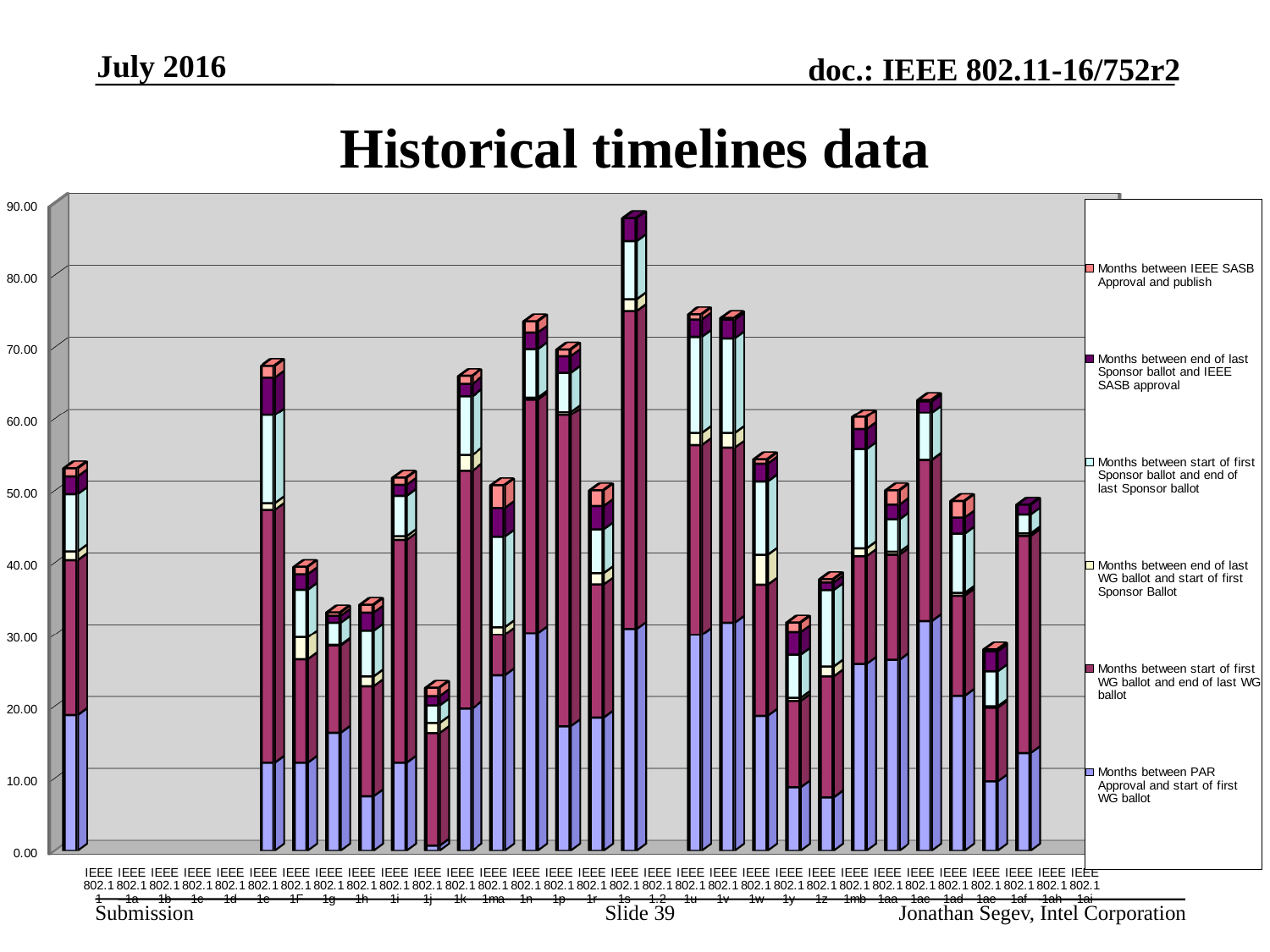
Which has the larger total stacked value, IEEE 802.11s or IEEE 802.11n? IEEE 802.11s Which legend entry corresponds to the bottom segment of each stacked bar? Months between PAR Approval and start of first WG ballot Is the total stacked value for IEEE 802.11j greater or less than 30? less Is the total stacked value for IEEE 802.11n greater or less than 70? greater Is the total stacked value for IEEE 802.11ac greater or less than 60? greater Which has the larger total stacked value, IEEE 802.11k or IEEE 802.11ma? IEEE 802.11k Which category with a plotted bar has the shortest stacked bar? IEEE 802.11j How many series does the legend list? 6 Which category has the tallest stacked bar? IEEE 802.11s What is the title of the chart? Historical timelines data What kind of chart is shown on the slide? Stacked bar chart